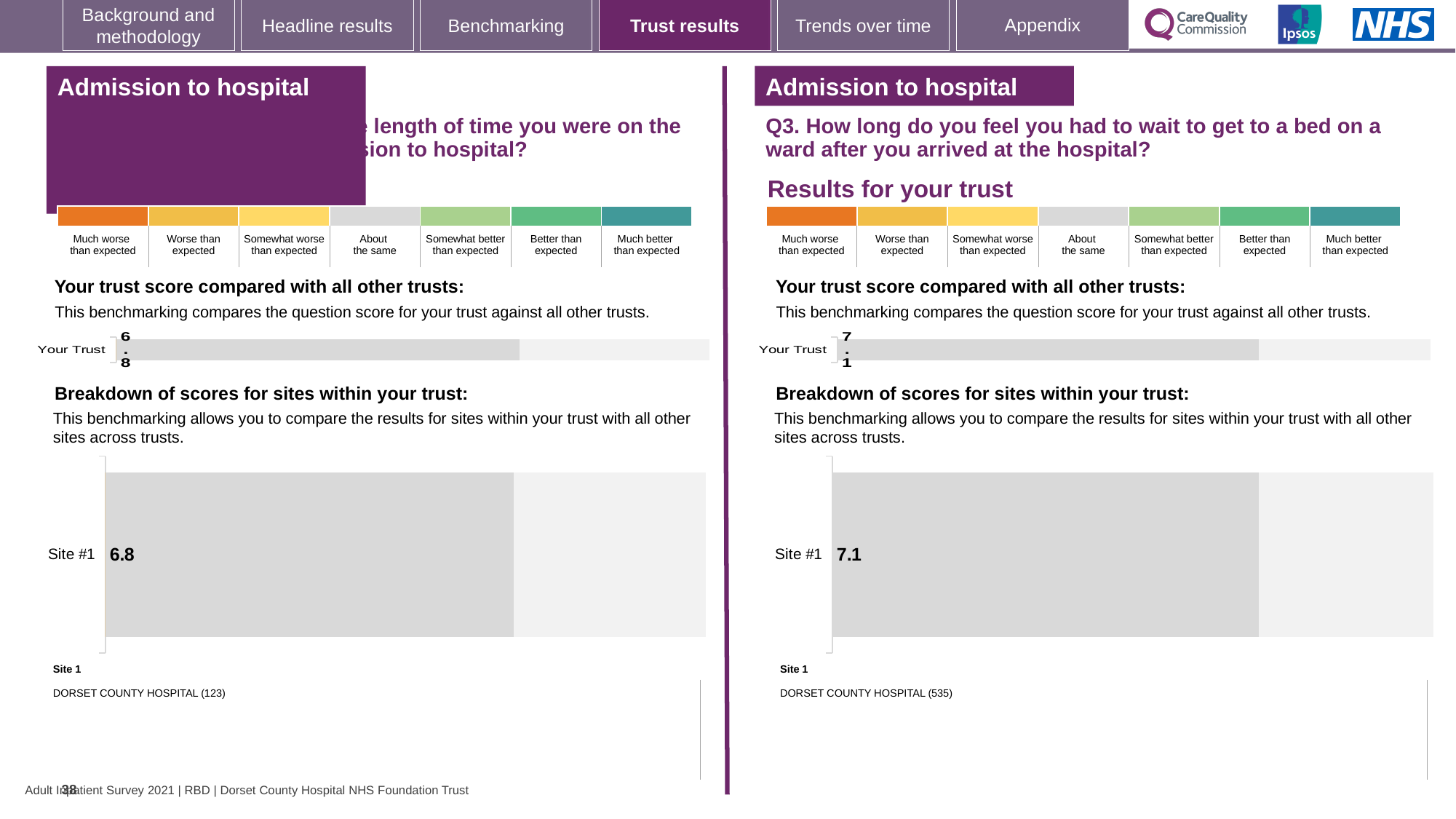
On the left panel, what score is shown for Site #1 in the breakdown of scores for sites? 6.8 On the right panel (Q3), what is the score shown for Your Trust? 7.1 What is the difference between the Your Trust score on the right panel (Q3) and the Your Trust score on the left panel? 0.3 What type of chart is used to show the Your Trust score on the right panel (Q3)? Bar chart On the right panel (Q3), what score is shown for Site #1 in the breakdown of scores for sites? 7.1 On the left panel, how many sites are shown in the breakdown of scores for sites within your trust chart? 1 On the right panel (Q3), how many sites are shown in the breakdown of scores for sites within your trust chart? 1 On the right panel (Q3), which hospital is listed as Site 1 below the breakdown chart? DORSET COUNTY HOSPITAL (535) On the left panel, what is the score shown for Your Trust? 6.8 Which is larger: the Site #1 score on the left panel or the Site #1 score on the right panel (Q3)? Right panel (Q3) How many rating categories are shown in the colour scale above the Your Trust chart on the right panel (Q3)? 7